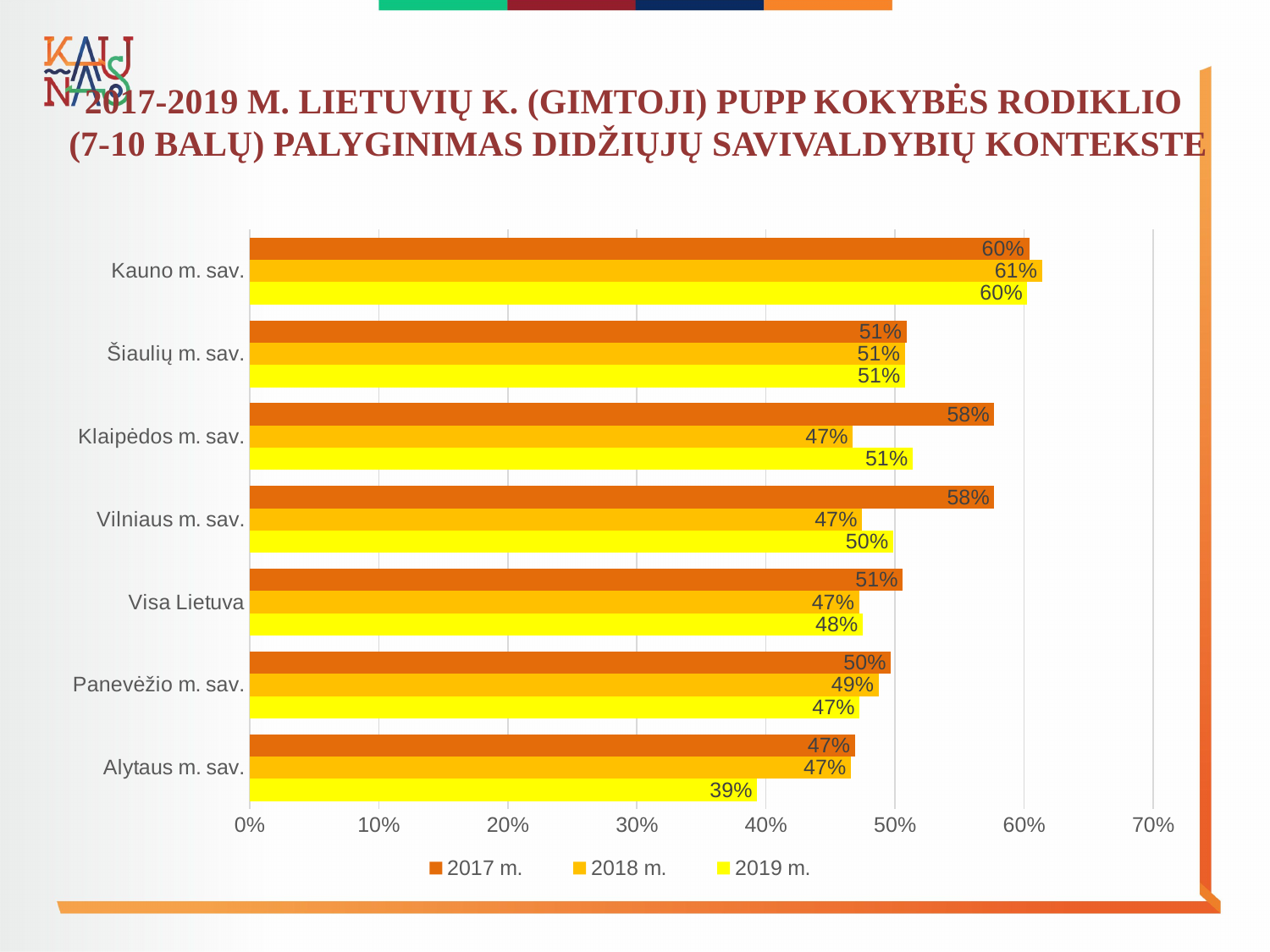
Which series is shown in yellow in the legend? 2019 m. What is the 2019 m. value for Alytaus m. sav.? 39% What is the difference between the 2017 m. and 2018 m. values for Vilniaus m. sav.? 11% How many series does the legend list? 3 How many categories are shown on the chart? 7 Which is larger for Panevėžio m. sav.: the 2017 m. value or the 2019 m. value? 2017 m. What is the 2019 m. value for Visa Lietuva? 48% Which category has the highest 2019 m. value? Kauno m. sav. Which category has the lowest 2019 m. value? Alytaus m. sav. What is the 2018 m. value for Kauno m. sav.? 61% What is the 2017 m. value for Klaipėdos m. sav.? 58% What kind of chart is shown on the slide? Bar chart